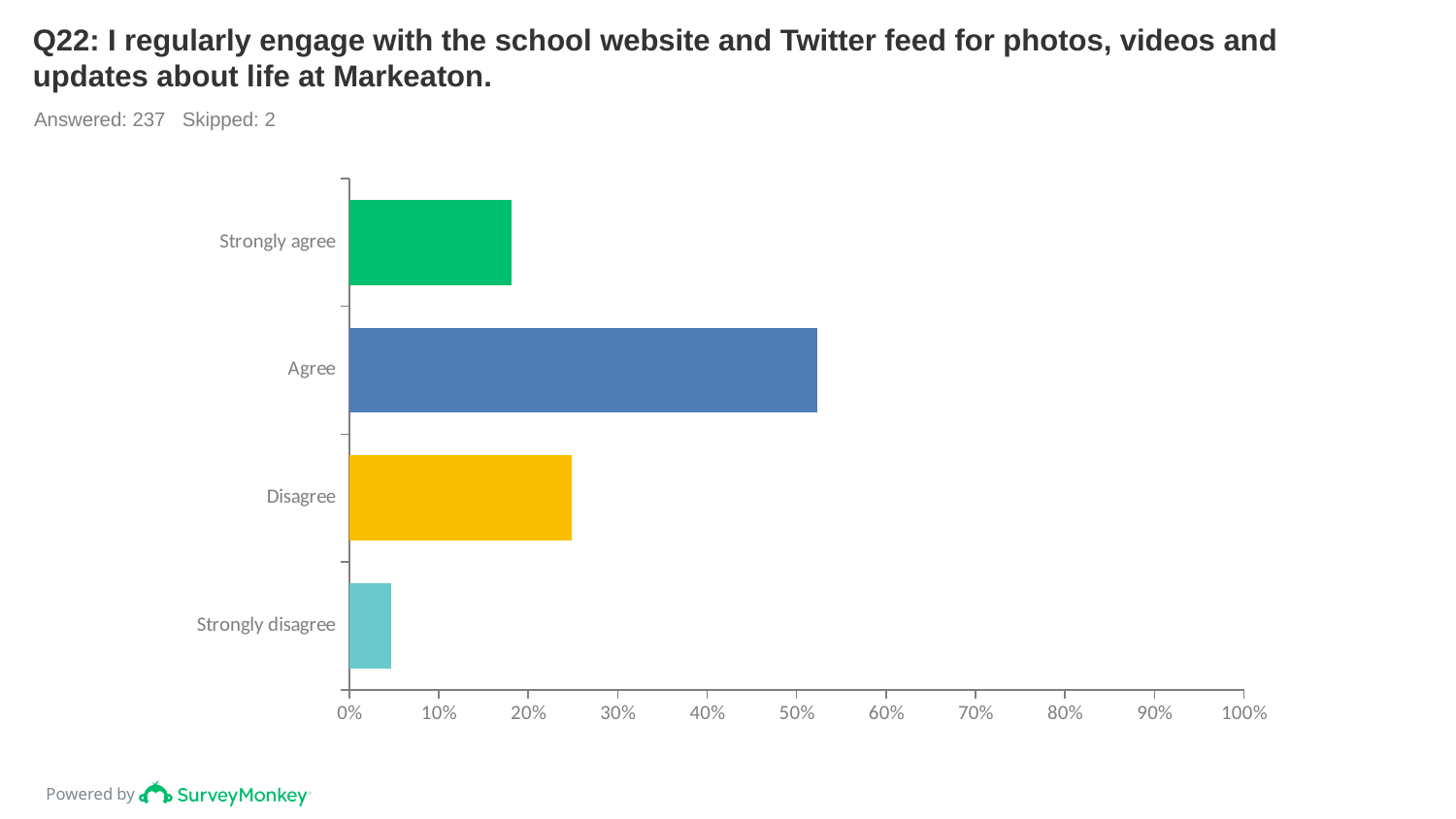
Is the value for Agree greater or less than 50%? greater Which is larger, the value for Agree or the value for Disagree? Agree Which response category has the lowest value? Strongly disagree Is the value for Strongly agree greater or less than 20%? less Which response category has the highest value? Agree How many respondents answered this question according to the slide? 237 Which is larger, the value for Disagree or the value for Strongly agree? Disagree What colour is the bar for Agree? blue Is the value for Disagree greater or less than 20%? greater What kind of chart is shown on the slide? bar chart How many response categories are shown in the chart? 4